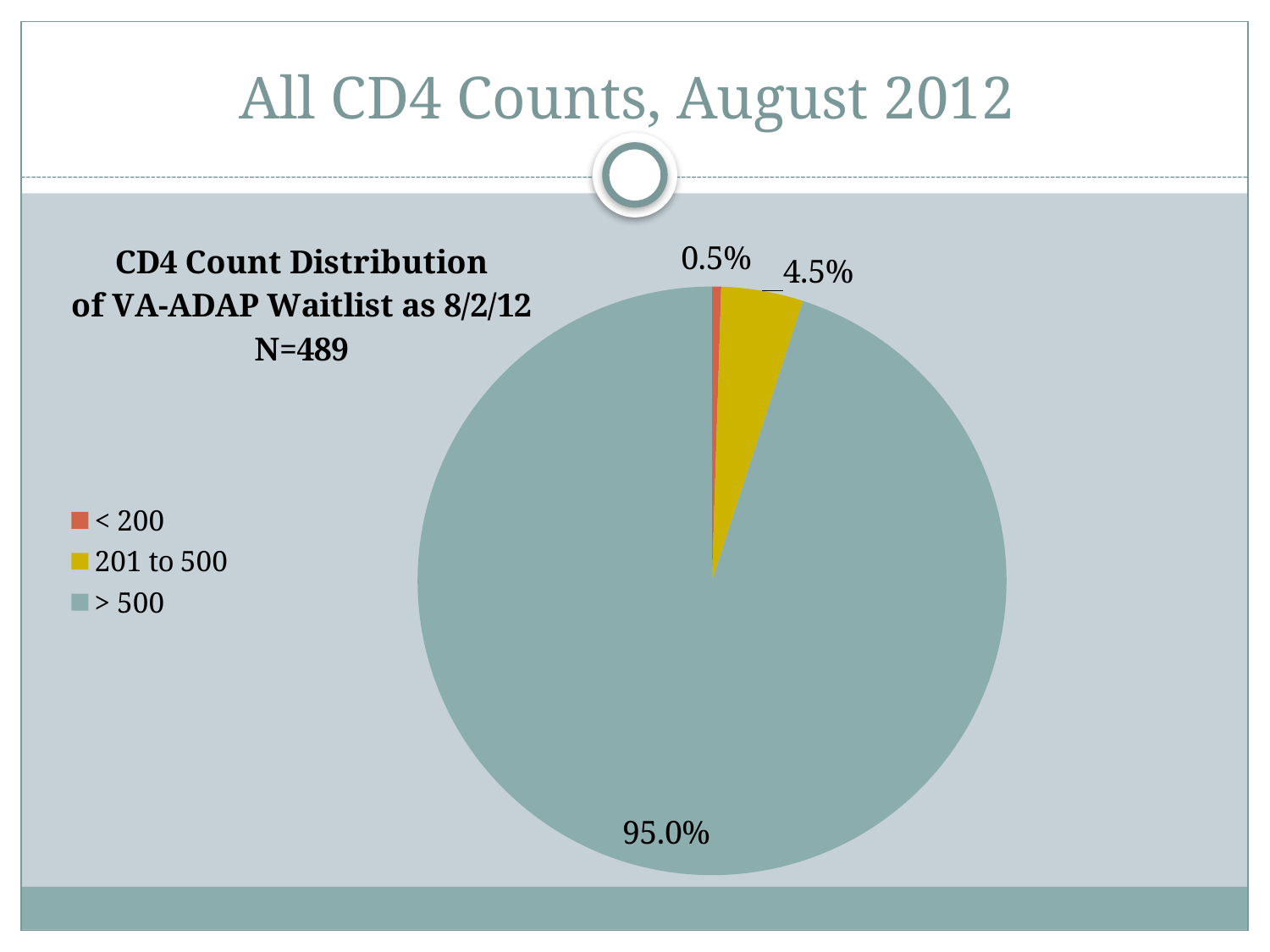
Which category has the largest slice of the pie? > 500 What is the difference in percentage points between the "201 to 500" slice and the "< 200" slice? 4.0% What share of the pie does the "< 200" category represent? 0.5% What colour is the "201 to 500" slice in the pie chart? yellow What share of the pie does the "201 to 500" category represent? 4.5% Which is larger, the "201 to 500" slice or the "< 200" slice? 201 to 500 What kind of chart is shown on the slide? pie chart What is the title of the pie chart? CD4 Count Distribution of VA-ADAP Waitlist as 8/2/12 N=489 How many categories does the pie chart show? 3 What is the sample size (N) stated in the chart title? 489 Which category has the smallest slice of the pie? < 200 What share of the pie does the "> 500" category represent? 95.0%